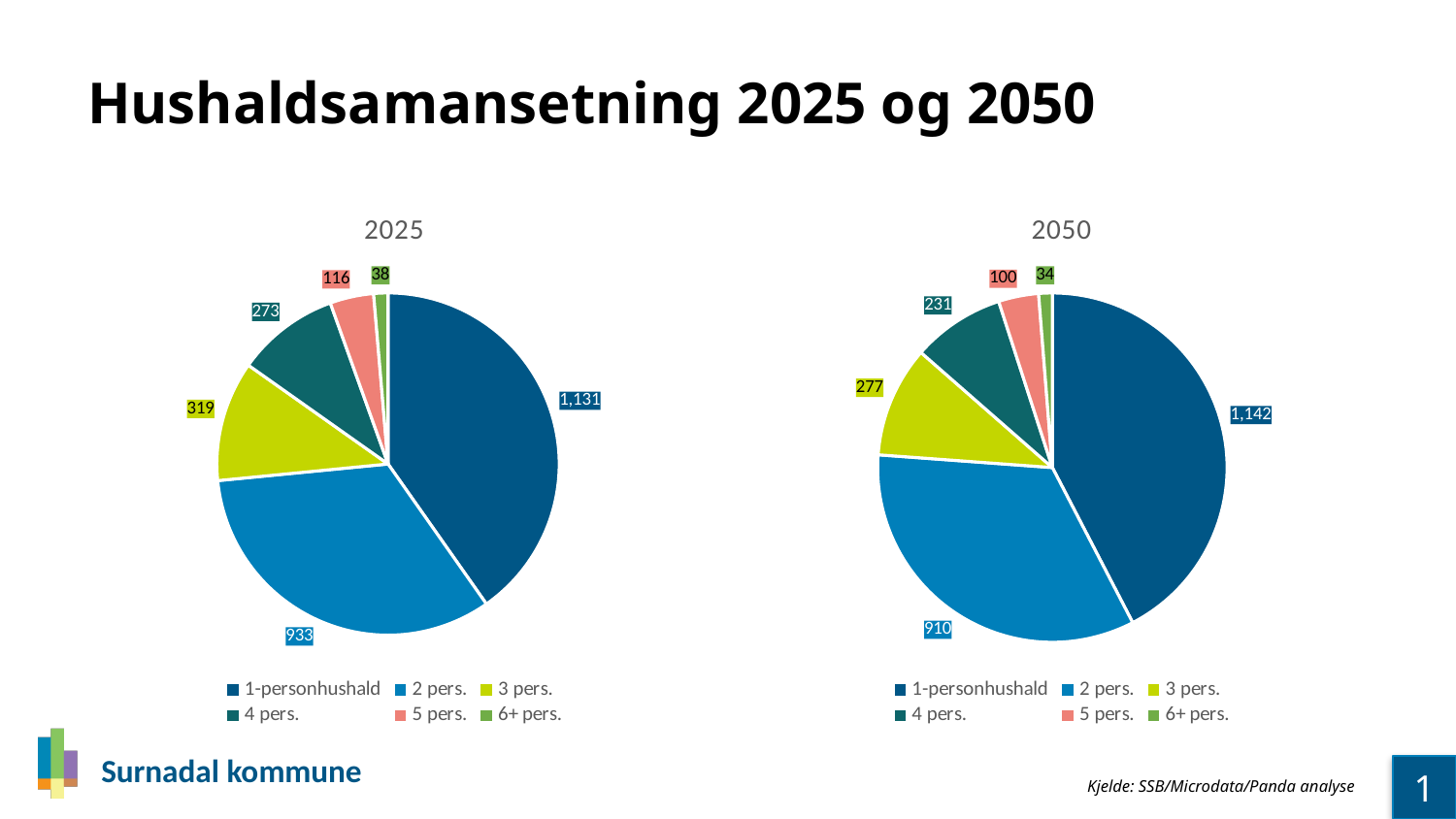
How many categories does the 2025 pie chart show? 6 What is the total of all slices in the 2050 pie chart? 2,694 What type of chart is used for the 2050 data? Pie chart In the 2050 pie chart, which category has the smallest slice? 6+ pers. In the 2025 pie chart, which category has the largest slice? 1-personhushald In the 2025 pie chart, what is the value for 1-personhushald? 1,131 What is the total of all slices in the 2025 pie chart? 2,810 What is the title of the slide containing the two pie charts? Hushaldsamansetning 2025 og 2050 In the 2025 pie chart, what is the value for 5 pers.? 116 In the 2050 pie chart, what is the difference between the values for 3 pers. and 4 pers.? 46 Which is larger: the value for 2 pers. in the 2025 chart or in the 2050 chart? 2025 (933) In the 2050 pie chart, what is the value for 2 pers.? 910